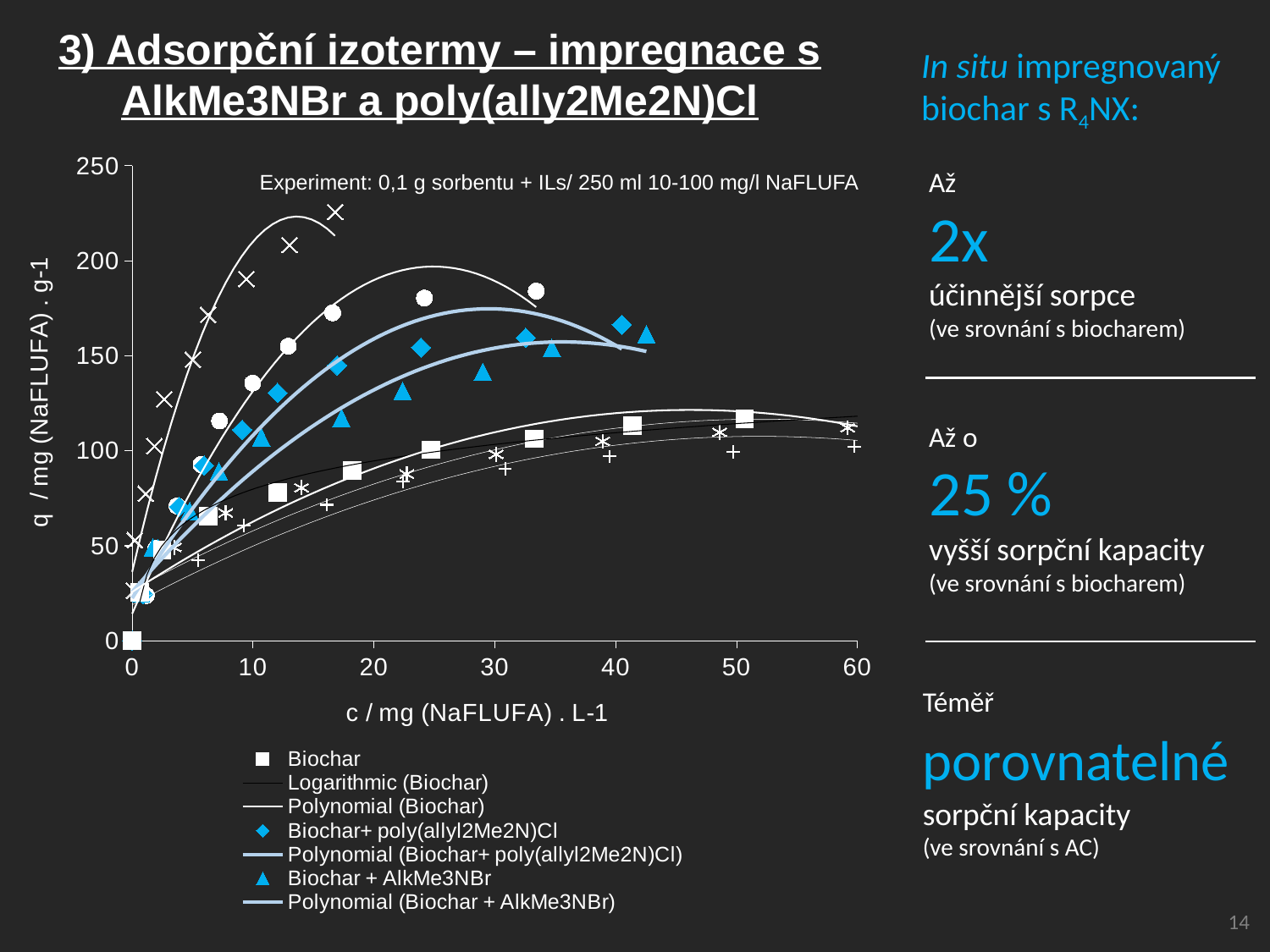
Is the Biochar + AlkMe3NBr value at c of about 30 greater or less than 150? less Do the Biochar values generally rise or fall as c increases along the x axis? rise What is the label of the x axis of the chart? c / mg (NaFLUFA) . L-1 Is the Biochar value at c of about 50 greater or less than 100? greater What is the label of the y axis of the chart? q / mg (NaFLUFA) . g-1 Is the Biochar+ poly(allyl2Me2N)Cl value at c of about 40 greater or less than 150? greater What kind of chart is shown on the slide? scatter chart What is the highest value shown on the x axis of the chart? 60 At c of about 40, which series has the larger q value: Biochar or Biochar+ poly(allyl2Me2N)Cl? Biochar+ poly(allyl2Me2N)Cl What is the highest value shown on the y axis of the chart? 250 How many entries does the chart legend list? 7